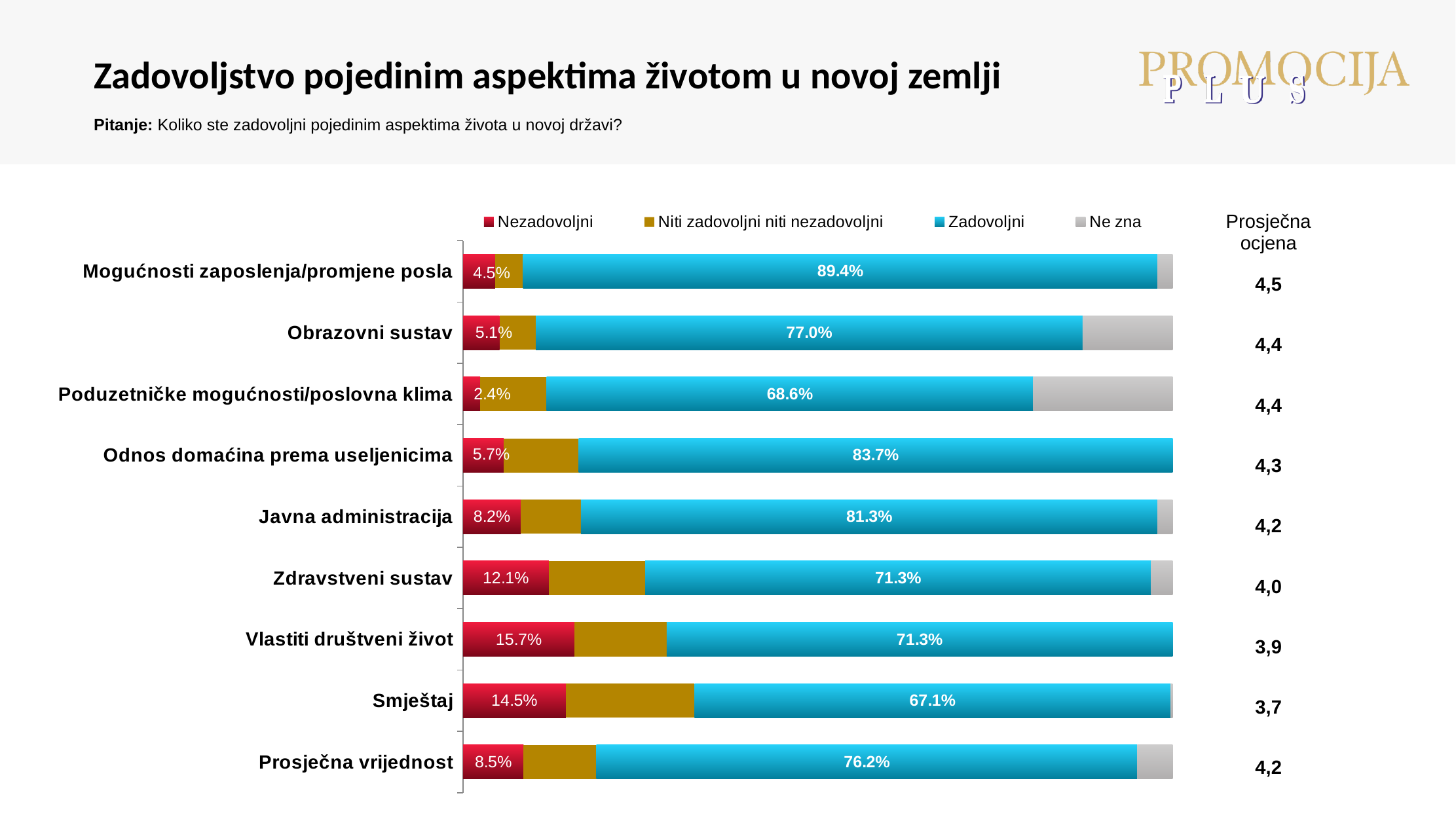
Which is larger, the Nezadovoljni value for Javna administracija or for Odnos domaćina prema useljenicima? Javna administracija How many series does the legend list? 4 What is the Nezadovoljni value for Zdravstveni sustav? 12.1% How many categories are plotted on the chart? 9 Which category has the highest Zadovoljni value? Mogućnosti zaposlenja/promjene posla What is the Zadovoljni value for Smještaj? 67.1% Which category has the highest Nezadovoljni value? Vlastiti društveni život What is the difference between the Zadovoljni values for Obrazovni sustav and Poduzetničke mogućnosti/poslovna klima? 8.4% Which category has the lowest Nezadovoljni value? Poduzetničke mogućnosti/poslovna klima What is the Zadovoljni value for Mogućnosti zaposlenja/promjene posla? 89.4% Which legend entry is shown in grey? Ne zna What kind of chart is shown on the slide? Stacked bar chart